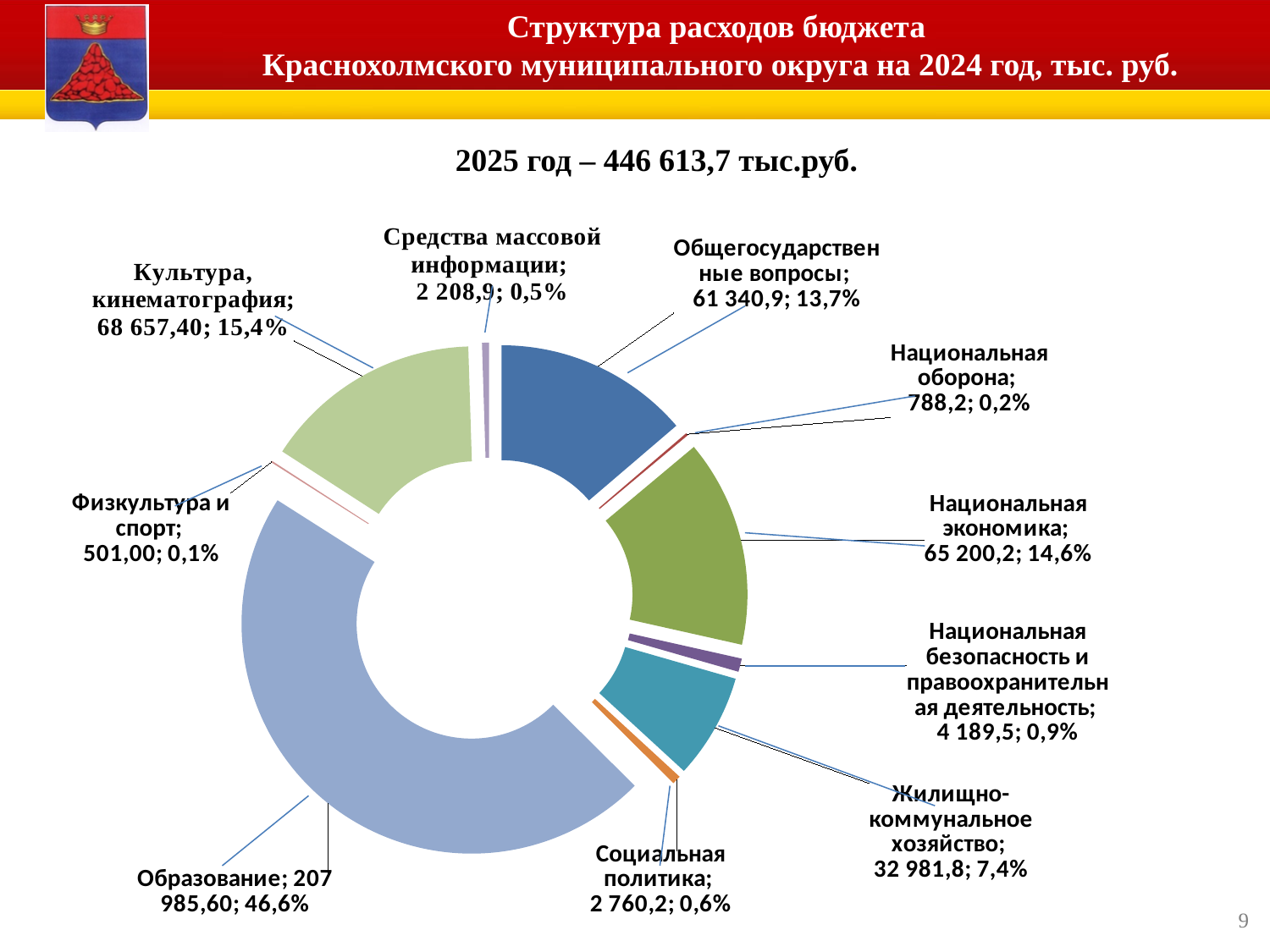
Which category has the smallest share of the budget? Физкультура и спорт What share of the total does Национальная экономика represent? 14,6% Which is larger: Культура, кинематография or Общегосударственные вопросы? Культура, кинематография What share does Социальная политика represent? 0,6% What is the value for Жилищно-коммунальное хозяйство? 32 981,8 What kind of chart is shown on the slide? Doughnut (pie) chart What is the value for Образование? 207 985,60 What is the difference in percentage points between Культура, кинематография (15,4%) and Национальная экономика (14,6%)? 0,8% Which category has the largest share of the budget? Образование What is the value for Национальная безопасность и правоохранительная деятельность? 4 189,5 What total amount for 2025 is stated above the chart? 446 613,7 тыс.руб. How many categories does the doughnut chart show? 10